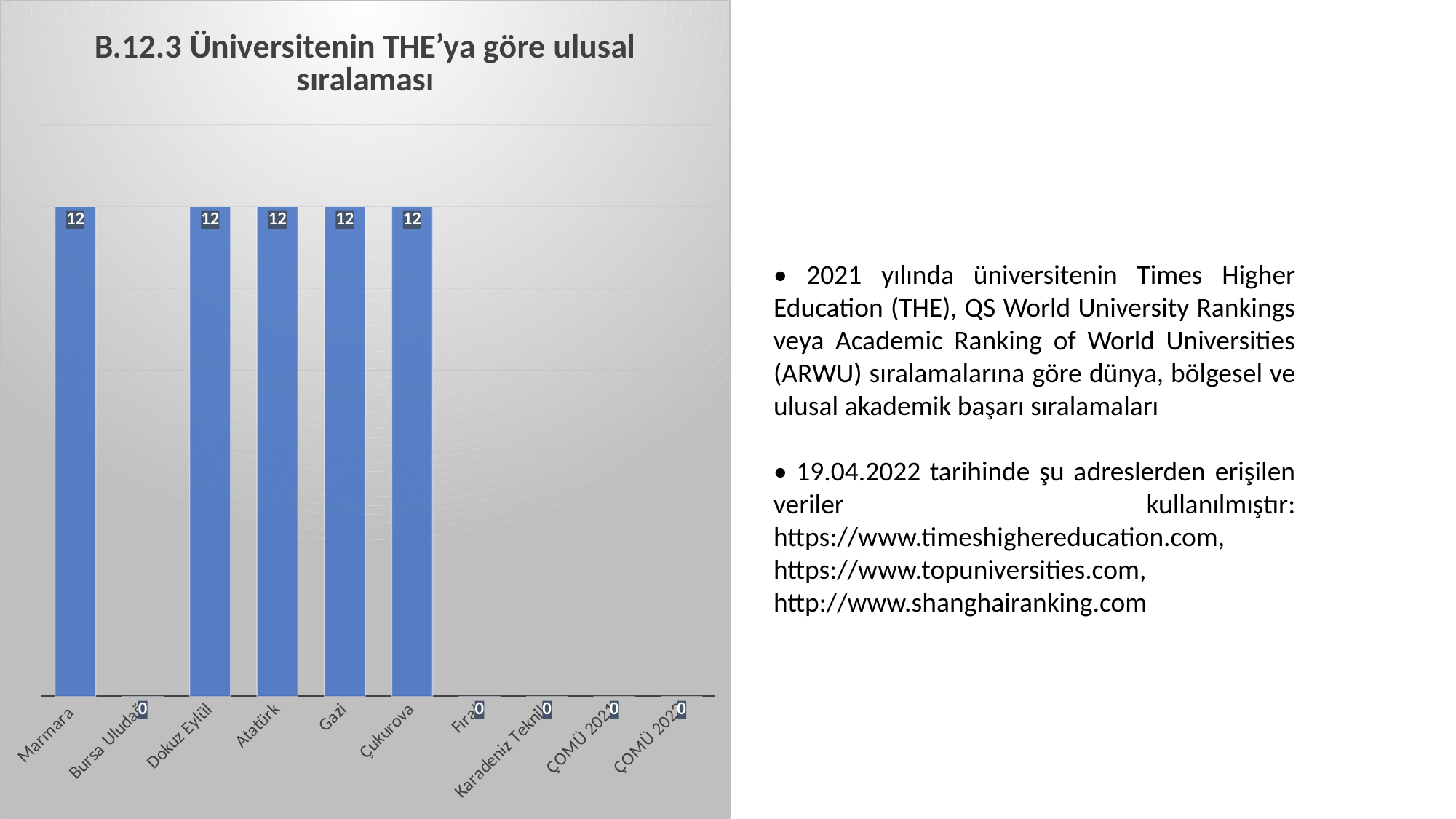
Which has the larger value, Atatürk or Bursa Uludağ? Atatürk What is the value for ÇOMÜ 2021? 0 What is the difference between the values for Çukurova and Fırat? 12 How many categories have a value of 12? 5 What is the title of the chart? B.12.3 Üniversitenin THE'ya göre ulusal sıralaması How many categories are shown on the x axis of the chart? 10 What is the value for Bursa Uludağ? 0 What kind of chart is shown on the slide? Bar chart What is the value for Karadeniz Teknik? 0 What is the value for Gazi? 12 What is the value for Marmara? 12 What is the highest value shown in the chart? 12